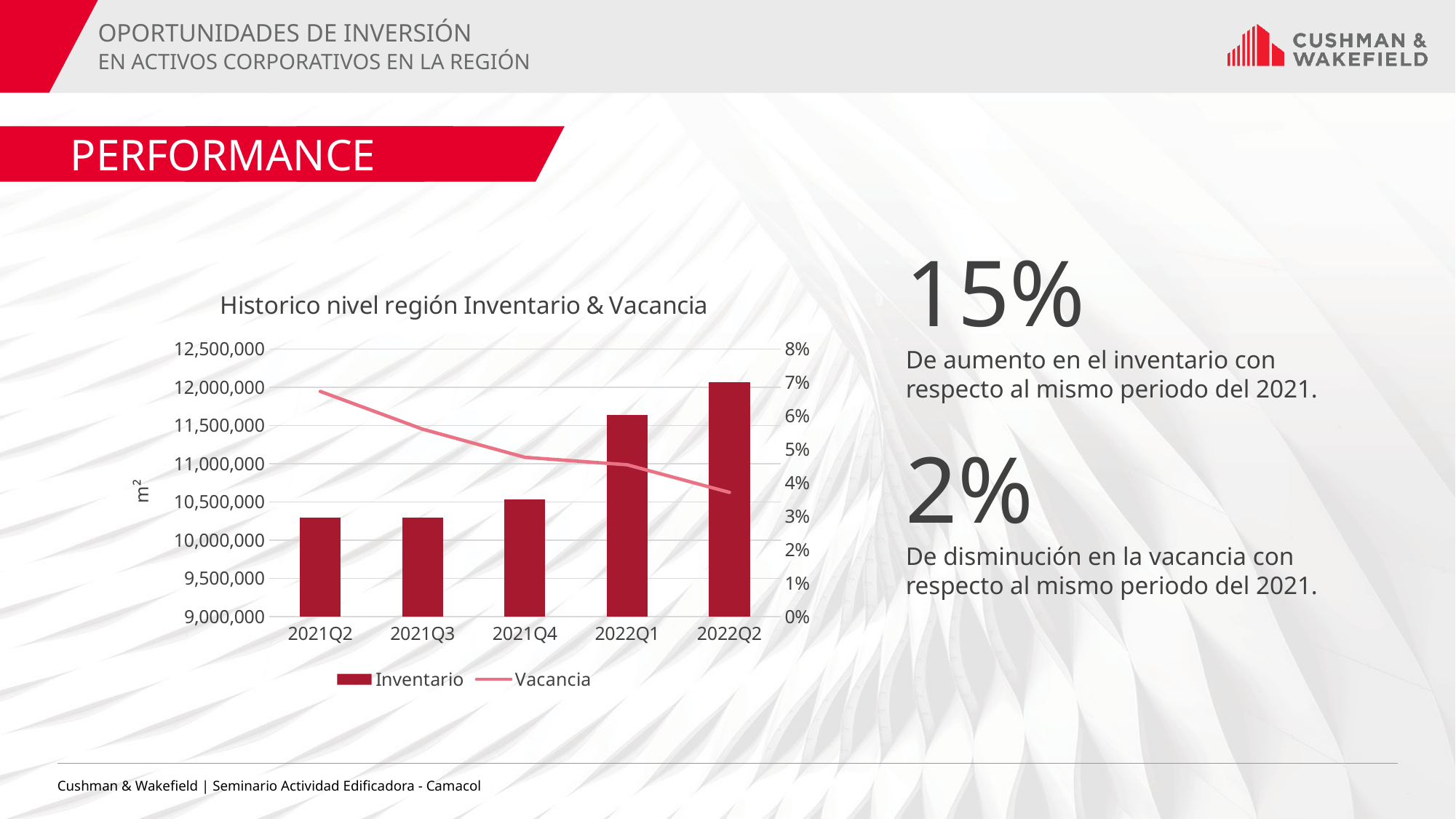
Which quarter has a larger Inventario bar, 2021Q4 or 2022Q1? 2022Q1 Which quarter has the highest Inventario bar? 2022Q2 Is the Vacancia value for 2021Q2 greater or less than 6%? greater How many quarters are shown on the x axis of the chart? 5 What kind of chart is used to show Inventario in the 'Historico nivel región Inventario & Vacancia' chart? Bar chart Is the Inventario value for 2021Q2 greater or less than 10,500,000? less Which quarter has the lowest Vacancia value? 2022Q2 Which quarter has the highest Vacancia value? 2021Q2 Does the Vacancia line rise or fall from 2021Q2 to 2022Q2? Fall Is the Inventario value for 2022Q1 greater or less than 11,500,000? greater How many series does the chart's legend list? 2